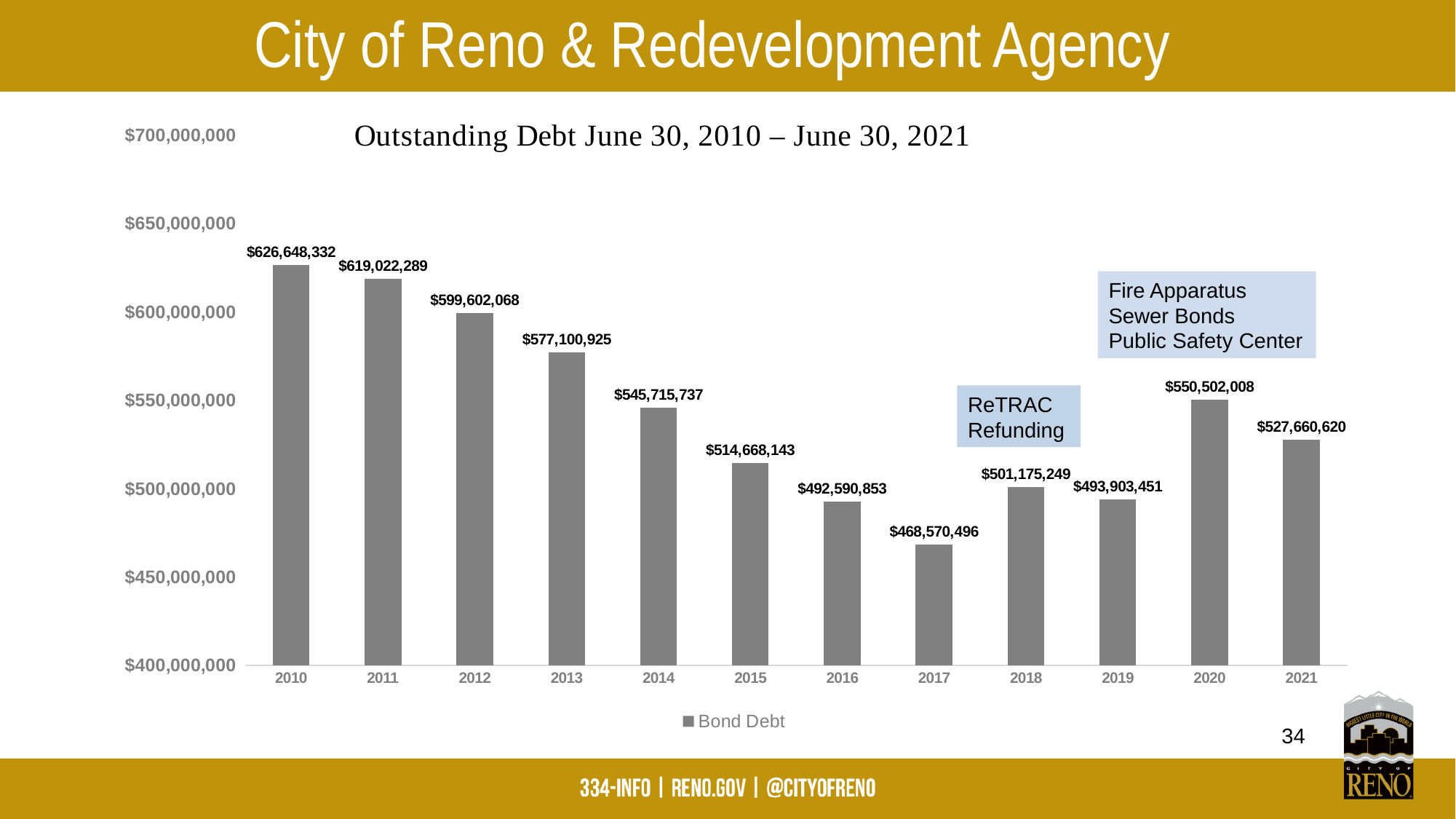
Which year has the lowest outstanding bond debt? 2017 What is the outstanding bond debt shown for 2017? $468,570,496 Which year has the highest outstanding bond debt? 2010 What is the difference between the bond debt in 2010 and in 2021? $98,987,712 What type of chart is shown on the slide? bar chart What is the outstanding bond debt shown for 2021? $527,660,620 Which year has the larger bond debt, 2018 or 2019? 2018 What is the difference between the bond debt in 2020 and in 2019? $56,598,557 How many series does the legend list? 1 What is the outstanding bond debt shown for 2010? $626,648,332 Is the bond debt for 2016 greater or less than $500,000,000? less How many years are shown on the chart? 12